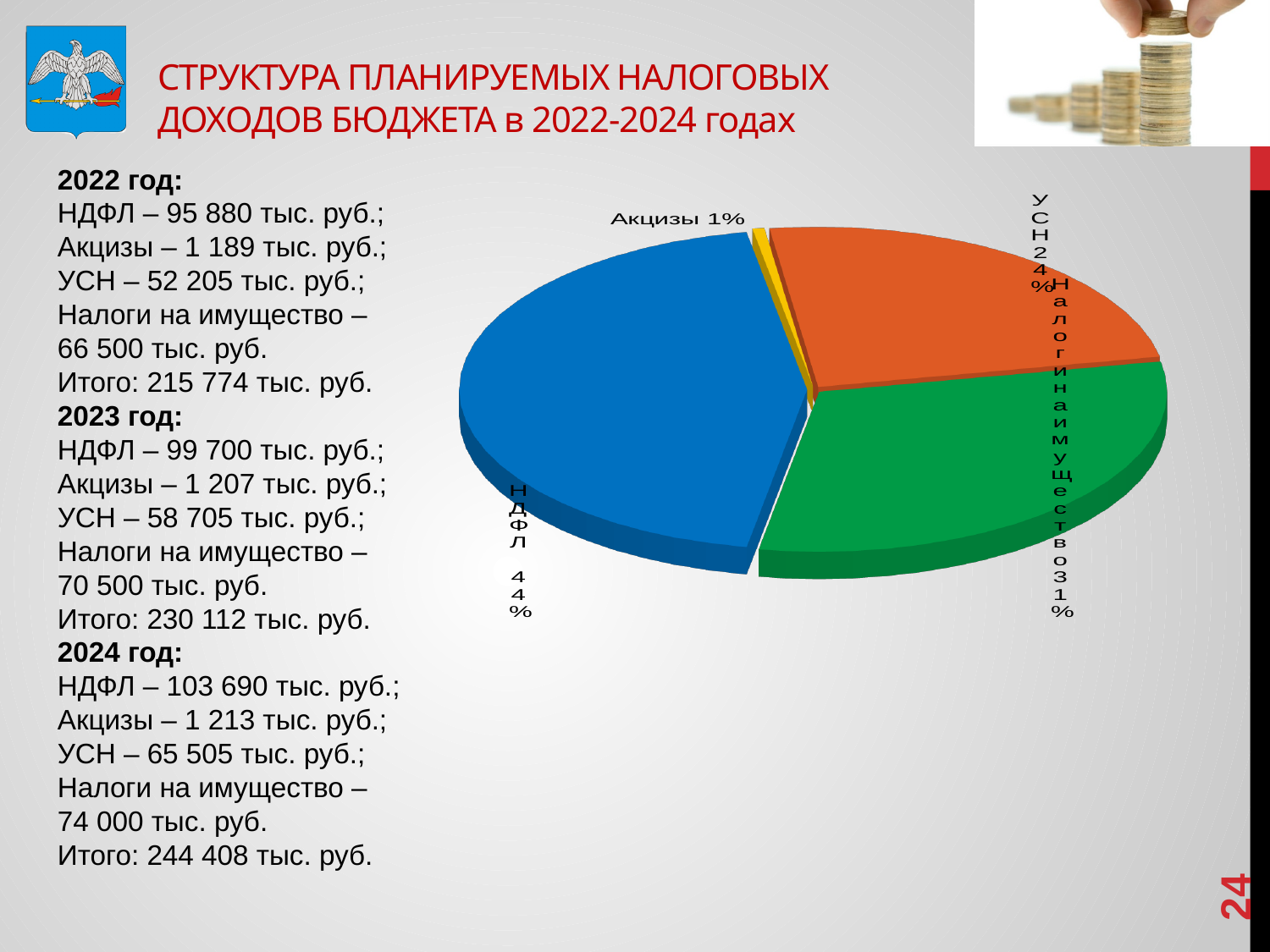
What is the difference in percentage points between the НДФЛ slice and the УСН slice? 20 What share of the pie does Налоги на имущество account for? 31% What share of the pie does Акцизы account for? 1% What kind of chart is shown on the slide? Pie chart Which slice of the pie chart is the smallest? Акцизы How many slices does the pie chart have? 4 Which is larger in the pie chart, УСН or Налоги на имущество? Налоги на имущество What colour is the НДФЛ slice in the pie chart? Blue What share of the pie does УСН account for? 24% What colour is the Акцизы slice in the pie chart? Yellow Which slice of the pie chart is the largest? НДФЛ